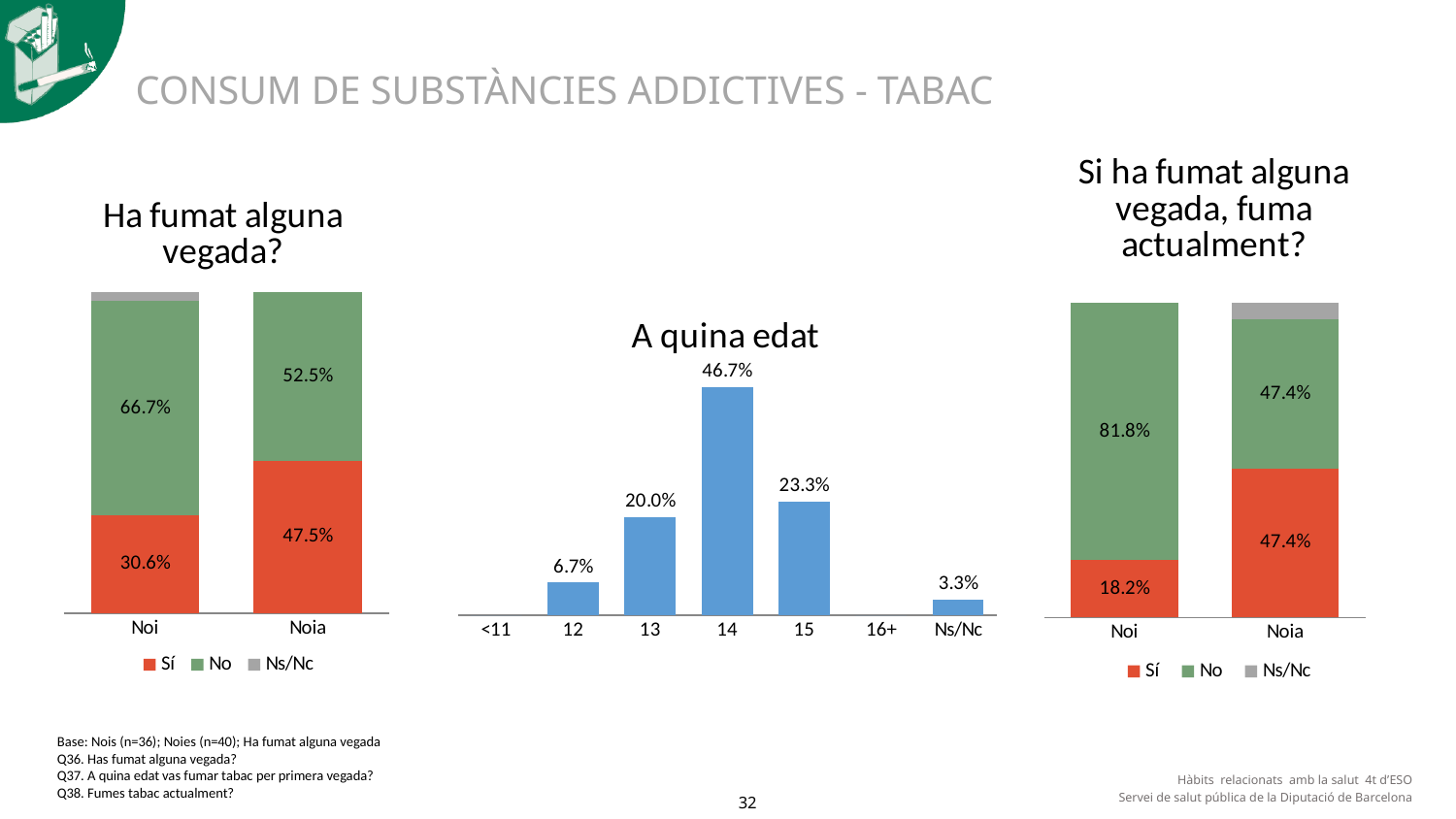
In the 'A quina edat' chart, which age category has the highest value? 14 In the 'Ha fumat alguna vegada?' chart, what is the 'No' value for Noia? 52.5% In the 'Ha fumat alguna vegada?' chart, what is the 'Sí' value for Noi? 30.6% How many series does the legend of the 'Si ha fumat alguna vegada, fuma actualment?' chart list? 3 How many categories are shown on the x axis of the 'A quina edat' chart? 7 In the 'A quina edat' chart, what is the value for age 13? 20.0% In the 'Si ha fumat alguna vegada, fuma actualment?' chart, what is the 'No' value for Noi? 81.8% In the 'A quina edat' chart, what is the difference between the values for age 14 and age 15? 23.4% What kind of chart is the 'A quina edat' chart? Bar chart In the 'Ha fumat alguna vegada?' chart, what is the difference between the 'No' values for Noi and Noia? 14.2% In the 'A quina edat' chart, what is the value for Ns/Nc? 3.3% In the 'Ha fumat alguna vegada?' chart, which group has the larger 'Sí' value, Noi or Noia? Noia